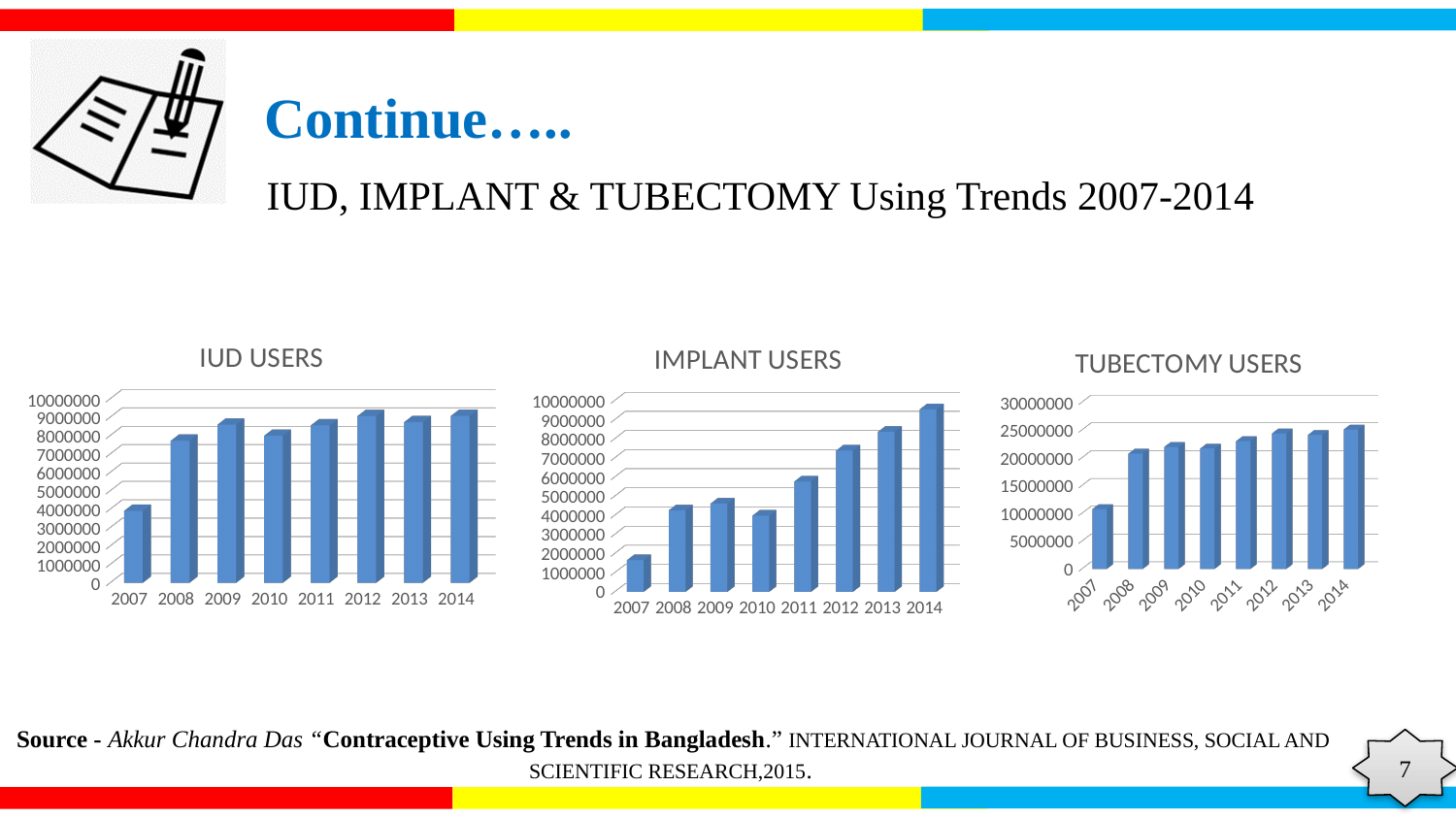
In the IUD USERS chart, is the value for 2007 greater or less than 5000000? less In the IUD USERS chart, which year has the lowest value? 2007 What kind of chart is the IMPLANT USERS chart? Bar chart In the IMPLANT USERS chart, do the values generally rise or fall from 2010 to 2014? Rise In the TUBECTOMY USERS chart, is the value for 2007 greater or less than 15000000? less How many years are shown on the x axis of the IUD USERS chart? 8 In the IMPLANT USERS chart, which year has the lowest value? 2007 In the IMPLANT USERS chart, is the value for 2014 greater or less than 9000000? greater In the IMPLANT USERS chart, which is larger, the value for 2012 or the value for 2010? 2012 In the TUBECTOMY USERS chart, which year has the lowest value? 2007 In the IMPLANT USERS chart, which year has the highest value? 2014